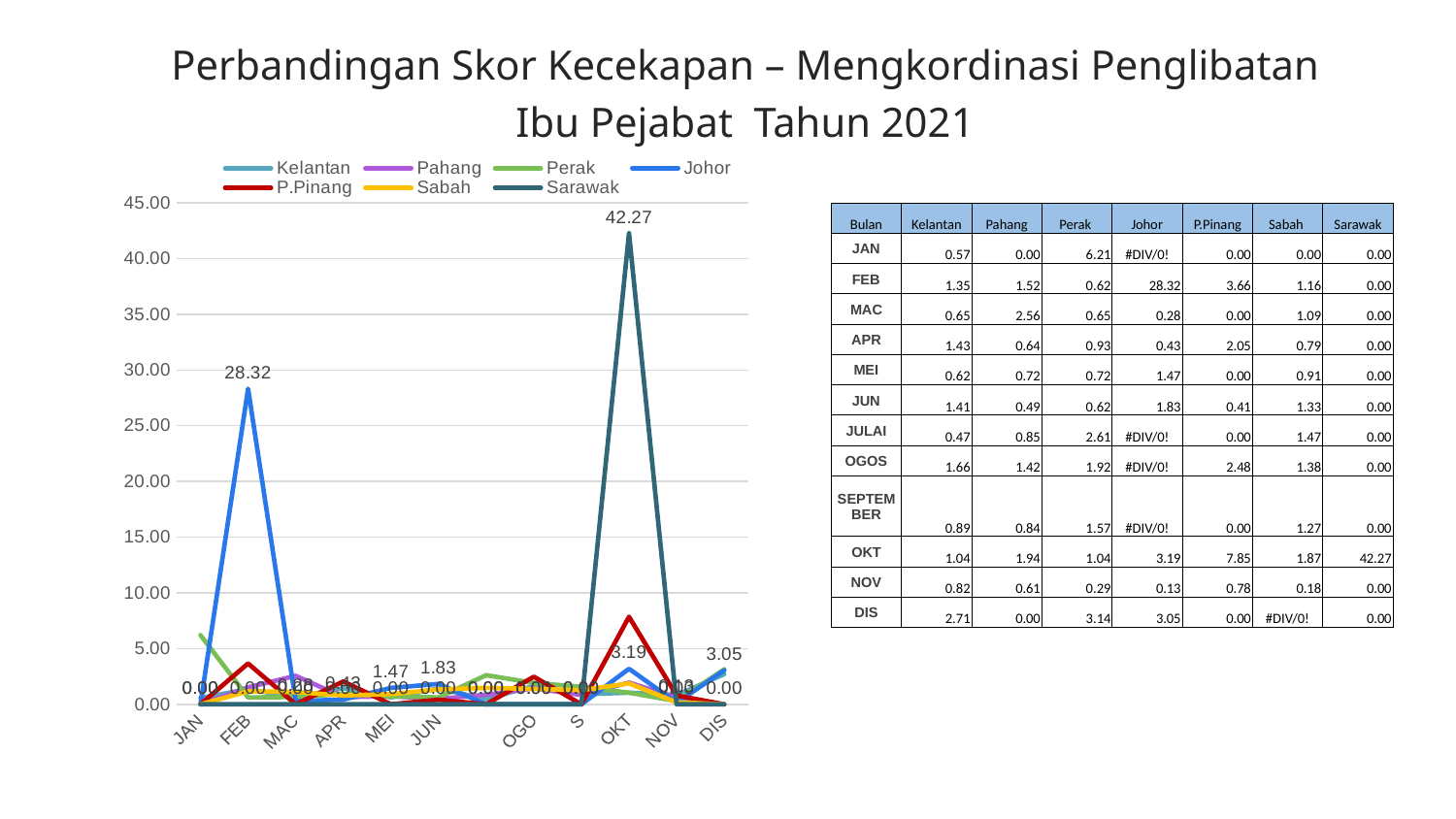
In which month does Sarawak reach its highest value? OKT What is the difference between the Sarawak value in OKT (42.27) and the Johor value in FEB (28.32)? 13.95 Is the value for Sarawak in OKT greater or less than 40.00? greater How many months are plotted along the x axis of the chart? 12 What is the value for Sarawak in OKT? 42.27 Which series is drawn in red in the chart? P.Pinang Which is larger: the Sarawak value in OKT or the Johor value in FEB? Sarawak in OKT Is the value for Johor in FEB greater or less than 25.00? greater How many series does the chart legend list? 7 What is the value for Johor in FEB? 28.32 What kind of chart is shown on the slide? line chart What is the value for Johor in DIS? 3.05